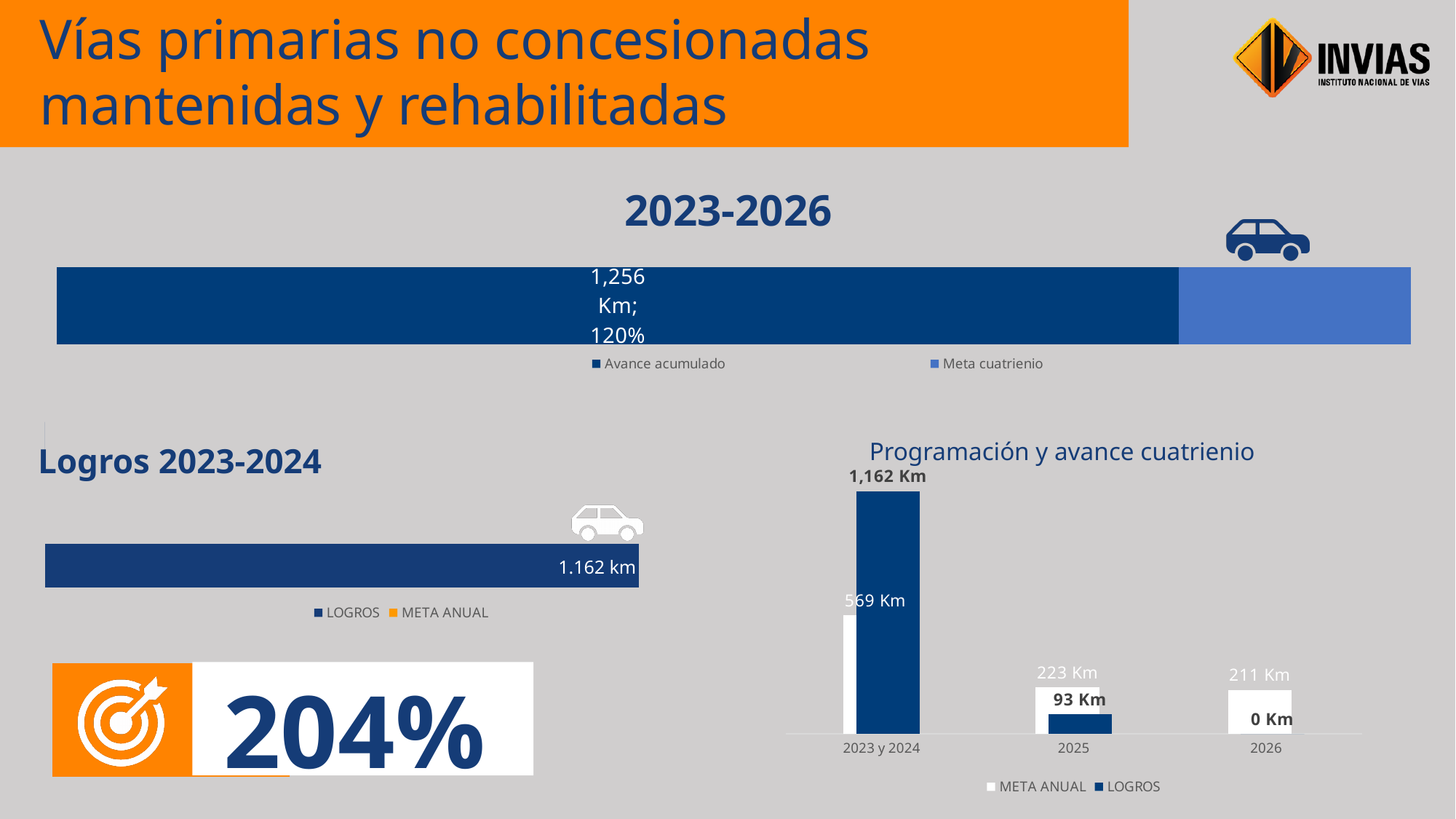
In the 'Programación y avance cuatrienio' chart, what is the LOGROS value for 2023 y 2024? 1,162 Km In the 'Programación y avance cuatrienio' chart, which year has the highest LOGROS value? 2023 y 2024 In the 'Programación y avance cuatrienio' chart, is the LOGROS value for 2025 larger or smaller than the META ANUAL value for 2025? smaller In the 'Programación y avance cuatrienio' chart, what is the META ANUAL value for 2025? 223 Km How many year categories are shown on the x axis of the 'Programación y avance cuatrienio' chart? 3 In the 'Programación y avance cuatrienio' chart, which year has the lowest META ANUAL value? 2026 In the 'Logros 2023-2024' chart, what is the LOGROS value? 1.162 km How many series does the legend of the 'Programación y avance cuatrienio' chart list? 2 In the 'Programación y avance cuatrienio' chart, what is the META ANUAL value for 2023 y 2024? 569 Km In the 'Programación y avance cuatrienio' chart, what is the difference between META ANUAL and LOGROS for 2025? 130 Km In the 'Programación y avance cuatrienio' chart, what is the LOGROS value for 2026? 0 Km In the '2023-2026' chart at the top of the slide, what value is labelled on the Avance acumulado bar? 1,256 Km; 120%